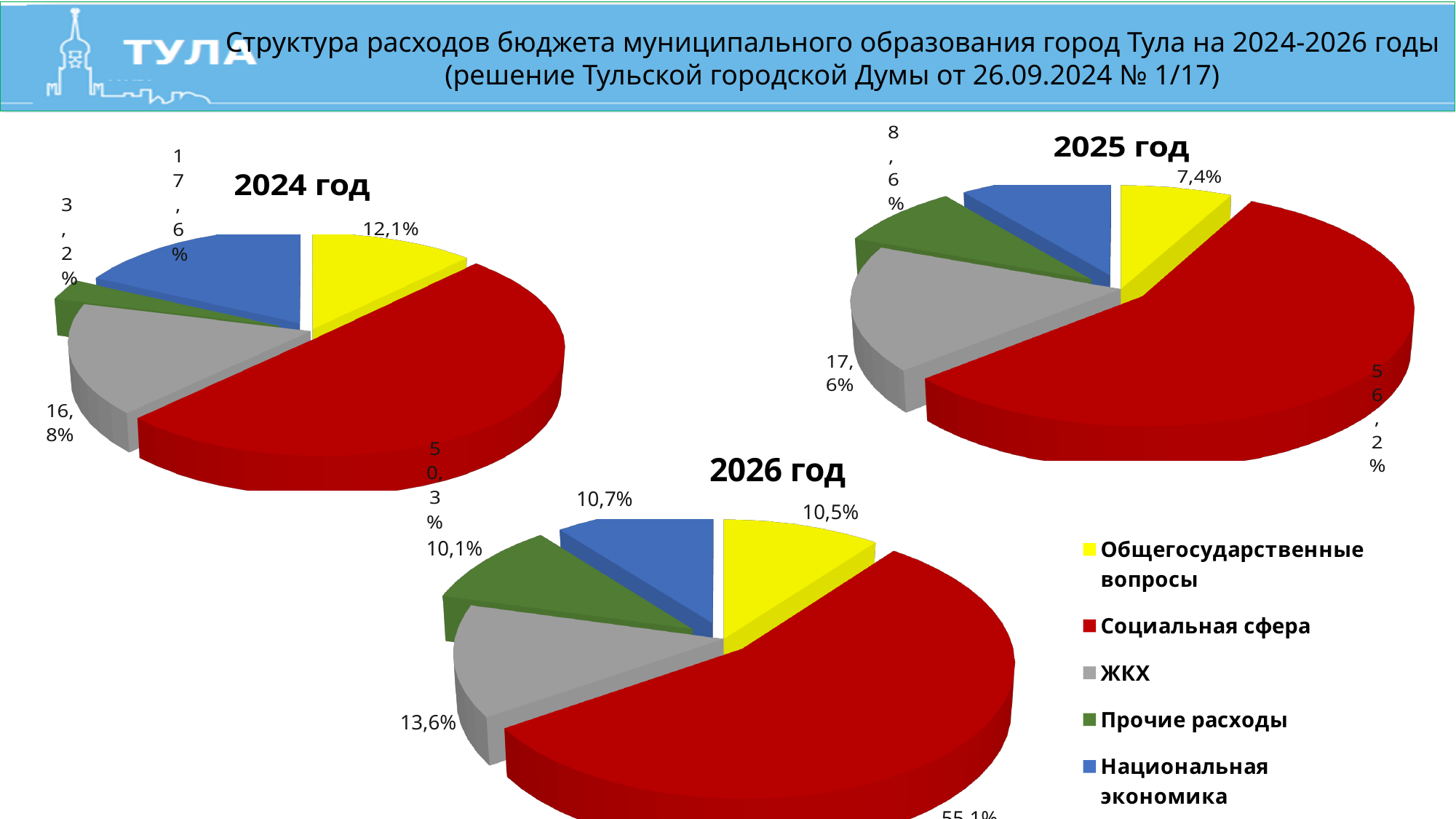
How many series does the legend list? 5 On the 2024 год chart, what share is Социальная сфера? 50,3% On the 2025 год chart, what share is Прочие расходы? 8,6% On the 2024 год chart, which category has the smallest share? Прочие расходы On the 2026 год chart, what share is ЖКХ? 13,6% What kind of chart is the 2026 год chart? Pie chart On the 2024 год chart, what share is Национальная экономика? 17,6% On the 2024 год chart, what share is ЖКХ? 16,8% On the 2025 год chart, which category has the largest share? Социальная сфера On the 2026 год chart, what is the difference between the shares of Социальная сфера and ЖКХ? 41,5% On the 2026 год chart, what share is Национальная экономика? 10,7% On the 2025 год chart, what share is Общегосударственные вопросы? 7,4%